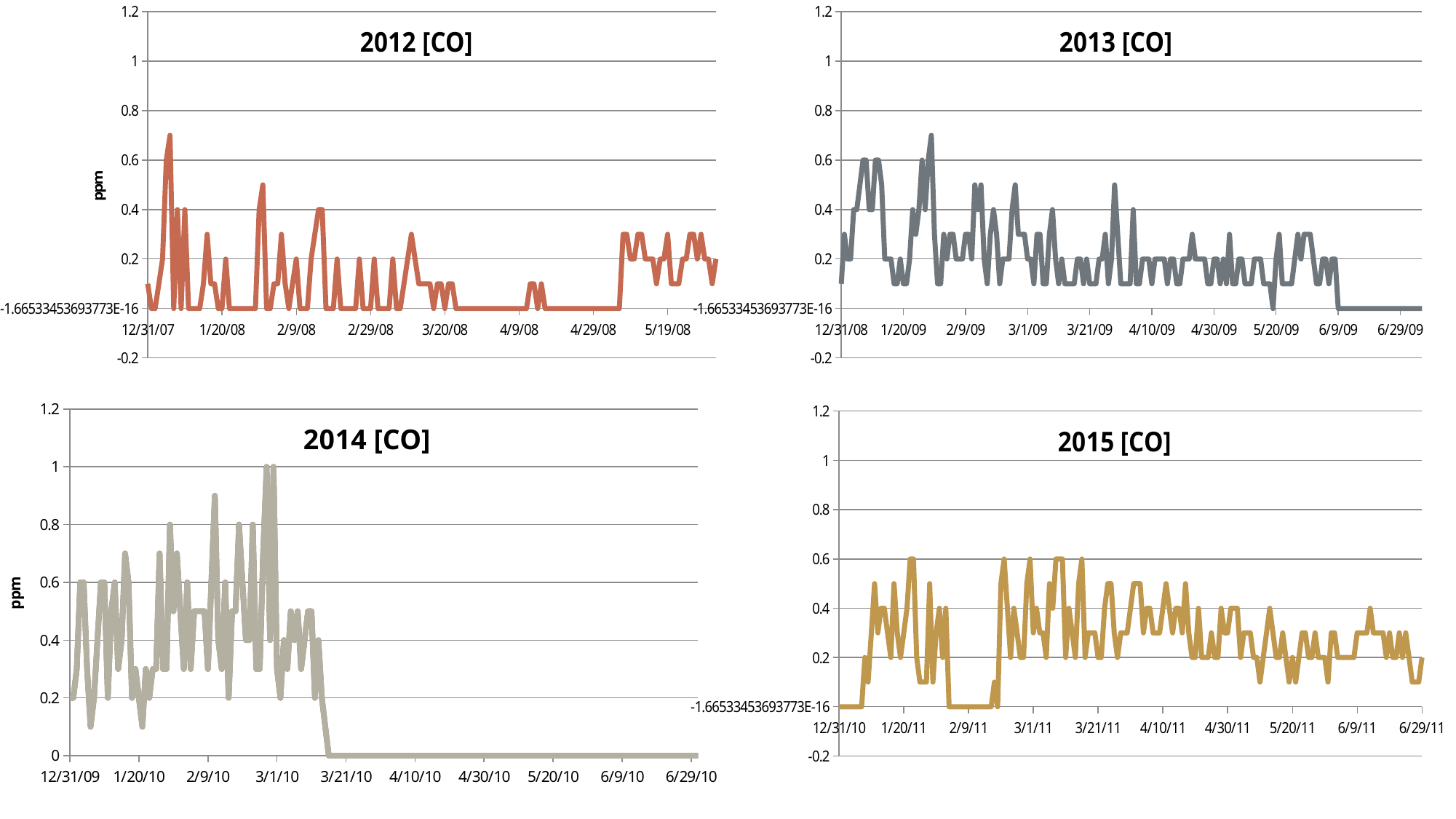
What kind of chart is the 2012 [CO] chart? line chart In the 2014 [CO] chart, what is the highest value reached by the line? 1 What is the title of the chart in the bottom-right position? 2015 [CO] Which chart reaches a higher peak value, 2014 [CO] or 2015 [CO]? 2014 [CO] In the 2014 [CO] chart, do the values generally rise or fall after 3/1/10? fall What is the y-axis label on the 2014 [CO] chart? ppm What is the first date shown on the x axis of the 2013 [CO] chart? 12/31/08 In the 2013 [CO] chart, is the highest peak greater or less than 0.8? less How many charts are shown on the slide? 4 In the 2015 [CO] chart, what is the highest value reached by the line? 0.6 In the 2012 [CO] chart, is the highest peak greater or less than 0.6? greater In the 2014 [CO] chart, is the value at 4/30/10 greater or less than 0.2? less